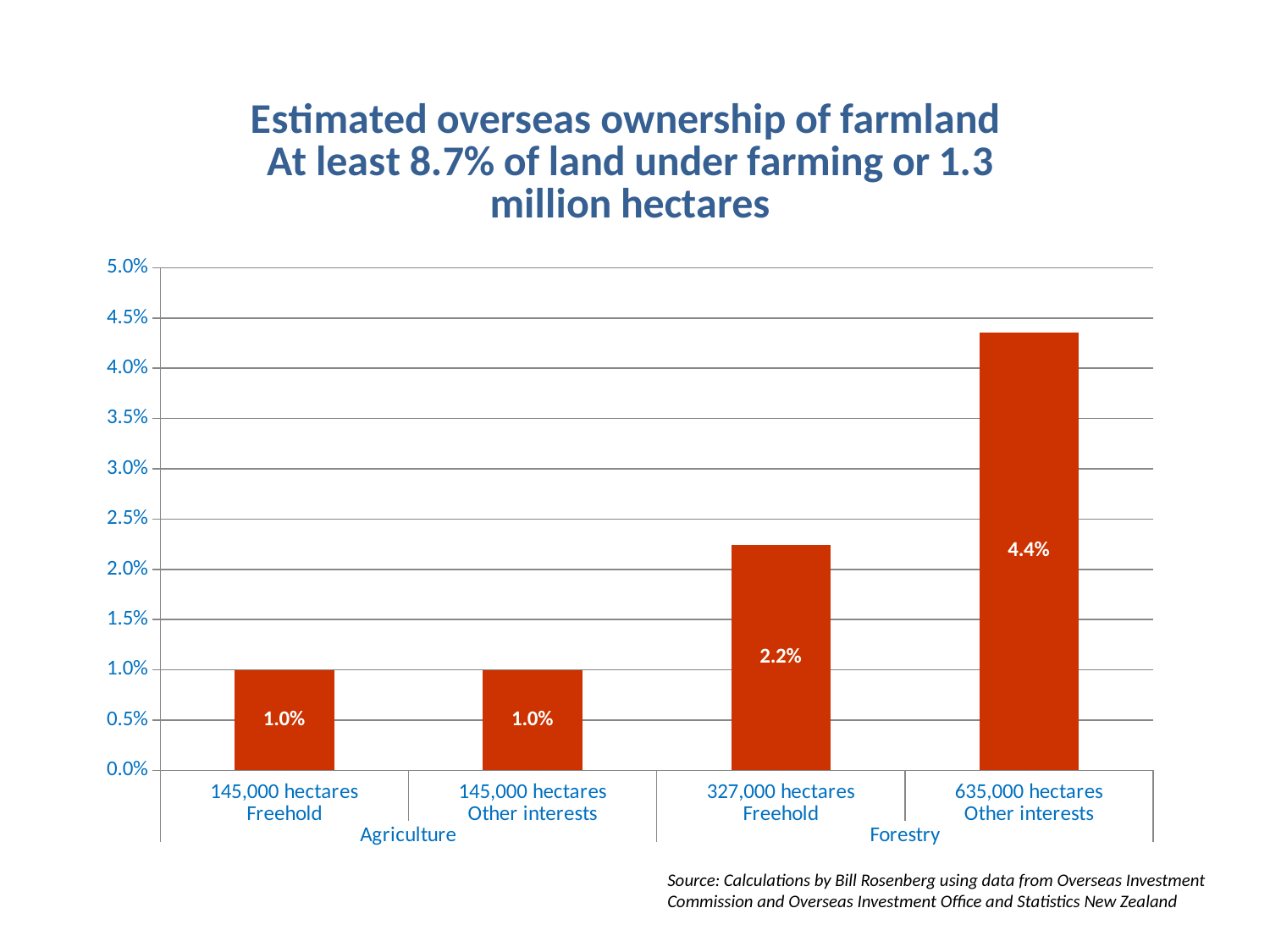
What is the value for Forestry Other interests (635,000 hectares)? 4.4% What is the difference between the Forestry Other interests value and the Forestry Freehold value? 2.2% Which is larger, the value for Forestry Freehold or the value for Agriculture Other interests? Forestry Freehold What is the difference between the Forestry Freehold value and the Agriculture Freehold value? 1.2% Which category has the highest value? Forestry Other interests (635,000 hectares) What kind of chart is shown on the slide? Bar chart How many bars are shown in the chart? 4 What is the highest value shown on the vertical axis? 5.0% Is the value for Forestry Other interests greater or less than 4.0%? greater What is the title of the chart? Estimated overseas ownership of farmland At least 8.7% of land under farming or 1.3 million hectares What is the value for Agriculture Freehold (145,000 hectares)? 1.0% What is the value for Forestry Freehold (327,000 hectares)? 2.2%